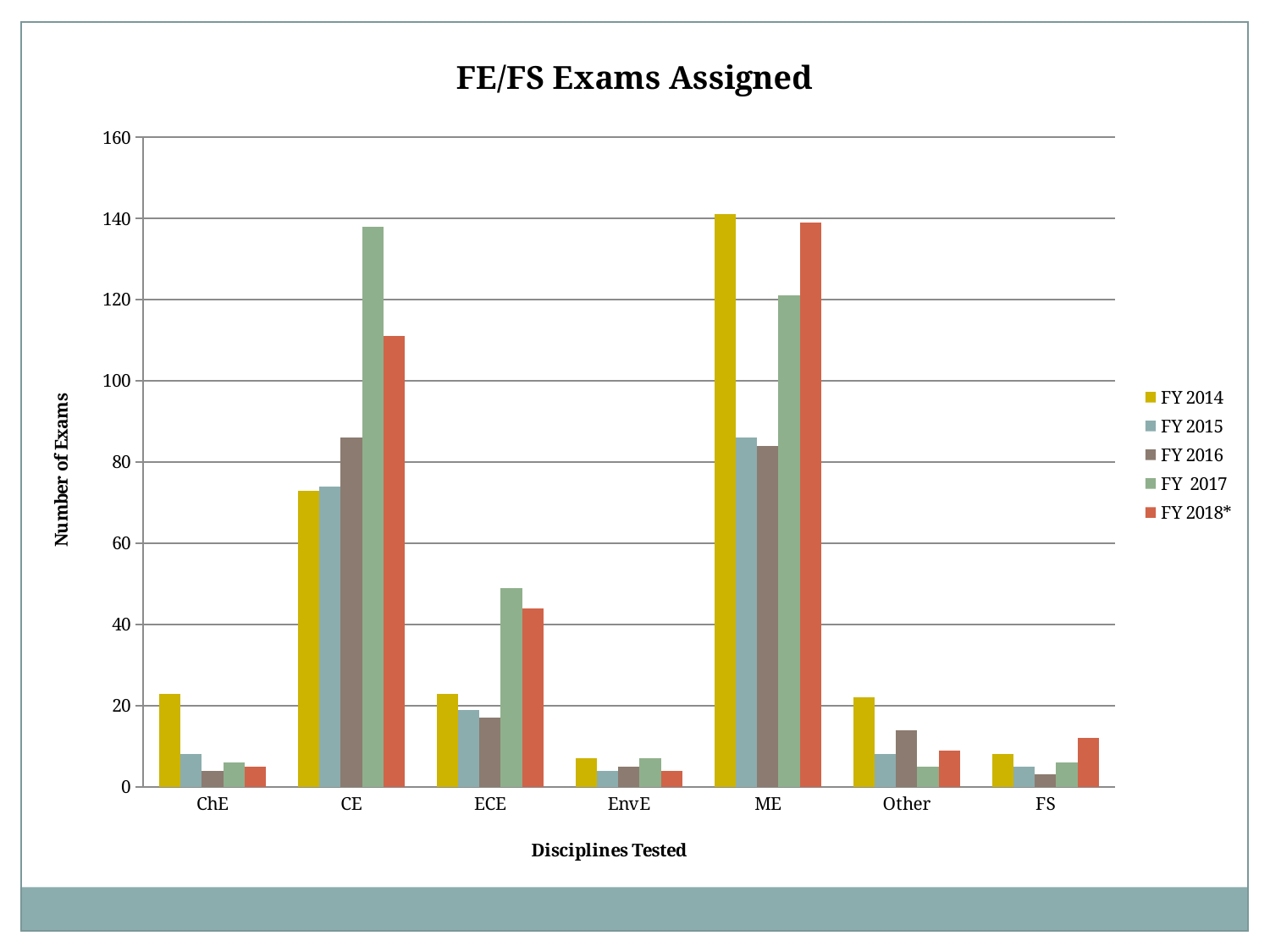
What kind of chart is shown on the slide? bar chart Which is larger for FY 2017: the value for CE or the value for ME? CE How many disciplines are shown on the x axis? 7 What is the title of the chart? FE/FS Exams Assigned Which discipline has the highest FY 2017 bar? CE Is the FY 2017 value for CE greater or less than 120? greater Which discipline has the highest FY 2014 bar? ME How many series does the legend list? 5 What is the label on the y axis? Number of Exams For CE, do the values rise or fall from FY 2014 to FY 2017? rise Is the FY 2014 value for EnvE greater or less than 20? less Is the FY 2017 value for ECE greater or less than 40? greater